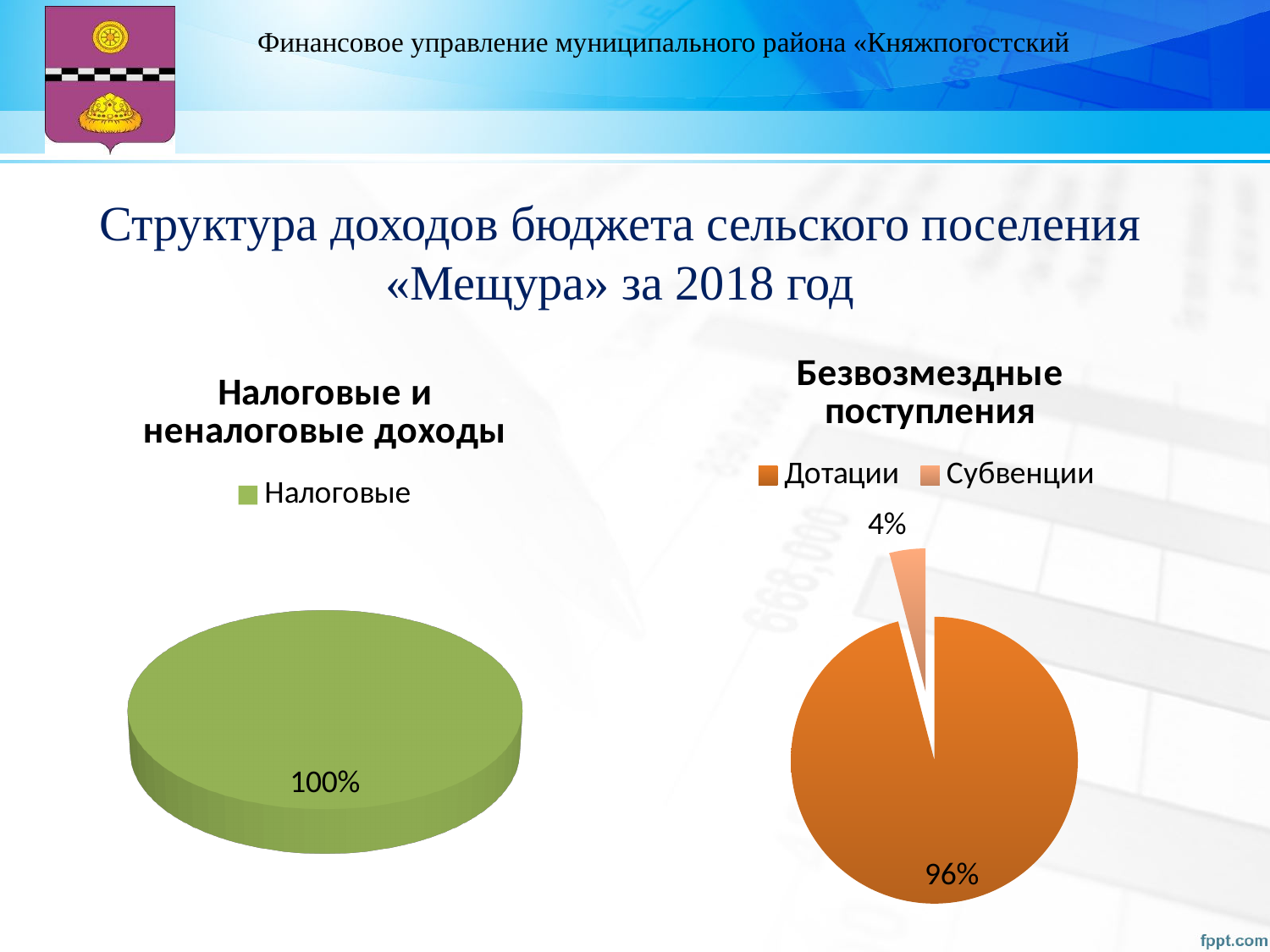
How many series does the legend of the chart titled «Безвозмездные поступления» list? 2 What is the title of the chart on the right side of the slide? Безвозмездные поступления How many series does the legend of the chart titled «Налоговые и неналоговые доходы» list? 1 What kind of chart is the chart on the left side of the slide? Pie chart In the chart titled «Безвозмездные поступления», what share does «Дотации» have? 96% In the chart titled «Безвозмездные поступления», which is larger: «Дотации» or «Субвенции»? Дотации In the chart titled «Безвозмездные поступления», which category has the smallest share? Субвенции In the chart titled «Безвозмездные поступления», which category has the largest share? Дотации What kind of chart is the chart titled «Безвозмездные поступления»? Pie chart In the chart titled «Безвозмездные поступления», what share does «Субвенции» have? 4% In the chart titled «Безвозмездные поступления», what is the difference between the shares of «Дотации» and «Субвенции»? 92% In the chart titled «Налоговые и неналоговые доходы», what share does «Налоговые» have? 100%